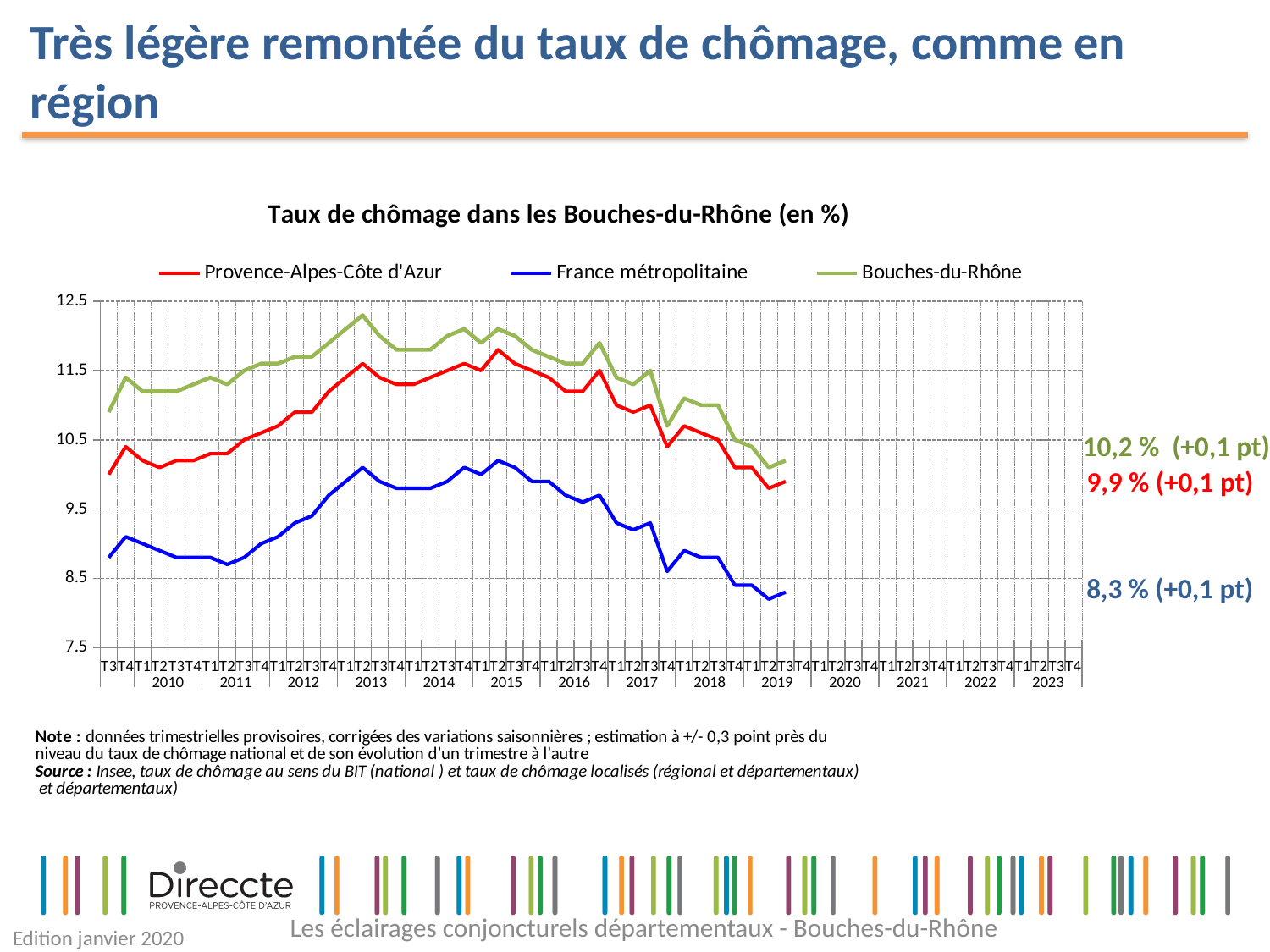
What is the difference between the latest values for Bouches-du-Rhône (10,2 %) and France métropolitaine (8,3 %)? 1,9 points What is the latest unemployment rate shown for France métropolitaine? 8,3 % Is the value for Bouches-du-Rhône at T2 2013 greater or less than 11.5? greater How many series does the legend of the chart list? 3 Which series has the highest value at the end of the chart? Bouches-du-Rhône What is the latest unemployment rate shown for Provence-Alpes-Côte d'Azur? 9,9 % What kind of chart is shown on the slide? line chart Which series has the lowest value at the end of the chart? France métropolitaine What is the title of the chart? Taux de chômage dans les Bouches-du-Rhône (en %) Is the value for France métropolitaine at T1 2010 greater or less than 9.5? less Between 2016 and 2019, do the unemployment rates generally rise or fall? fall What is the latest unemployment rate shown for Bouches-du-Rhône? 10,2 %